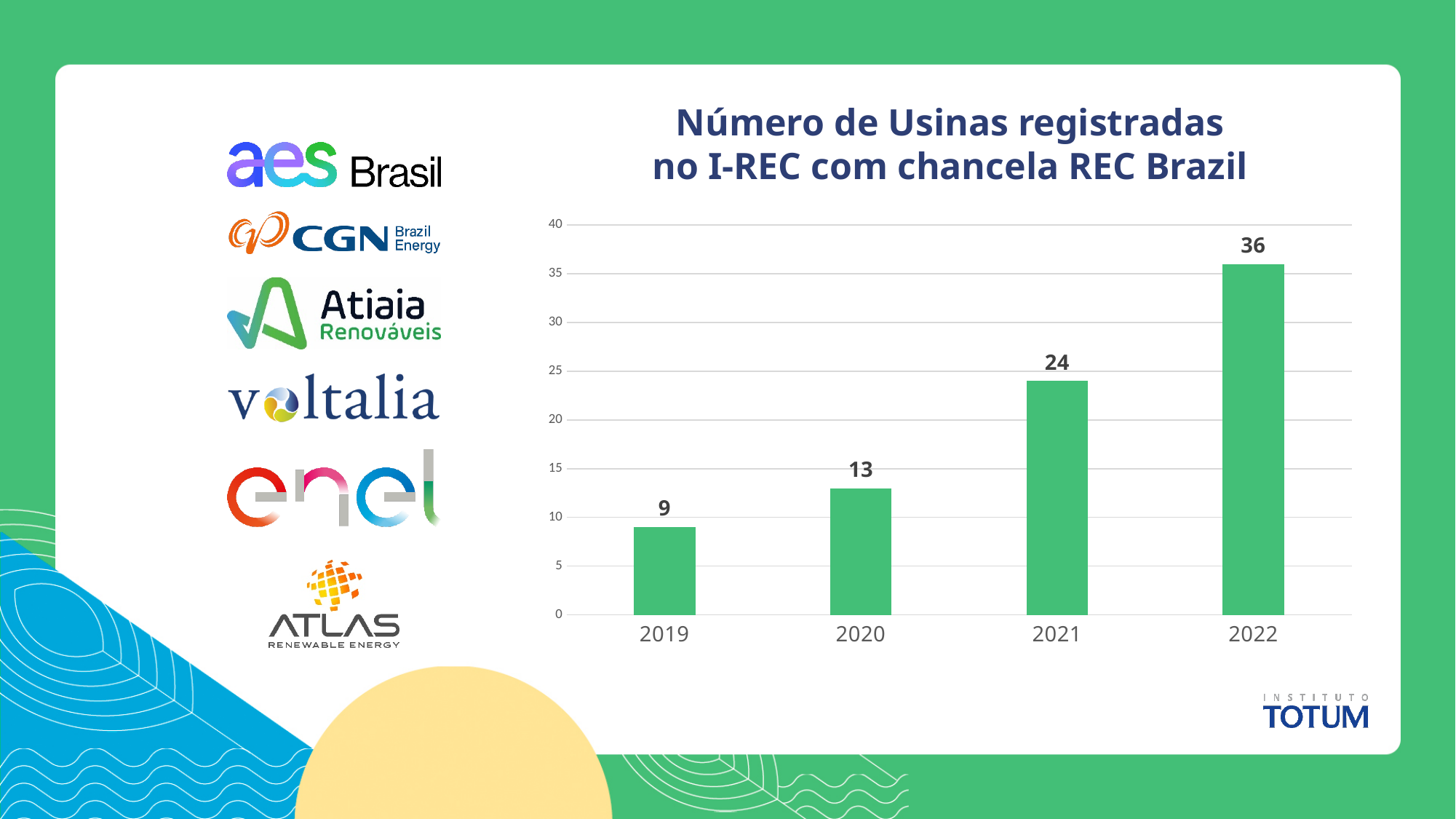
Is the value for 2022 greater or less than 30? greater What is the value shown for 2021? 24 What kind of chart is shown on the slide? Bar chart What is the difference between the values for 2022 and 2021? 12 Do the values rise or fall from 2019 to 2022? Rise How many years are shown on the x axis? 4 Which year has the lowest number of registered plants? 2019 Which is larger, the value for 2020 or the value for 2021? 2021 Which year has the highest number of registered plants? 2022 What is the number of plants registered in 2019? 9 What is the value shown for 2022? 36 What is the difference between the values for 2020 and 2019? 4